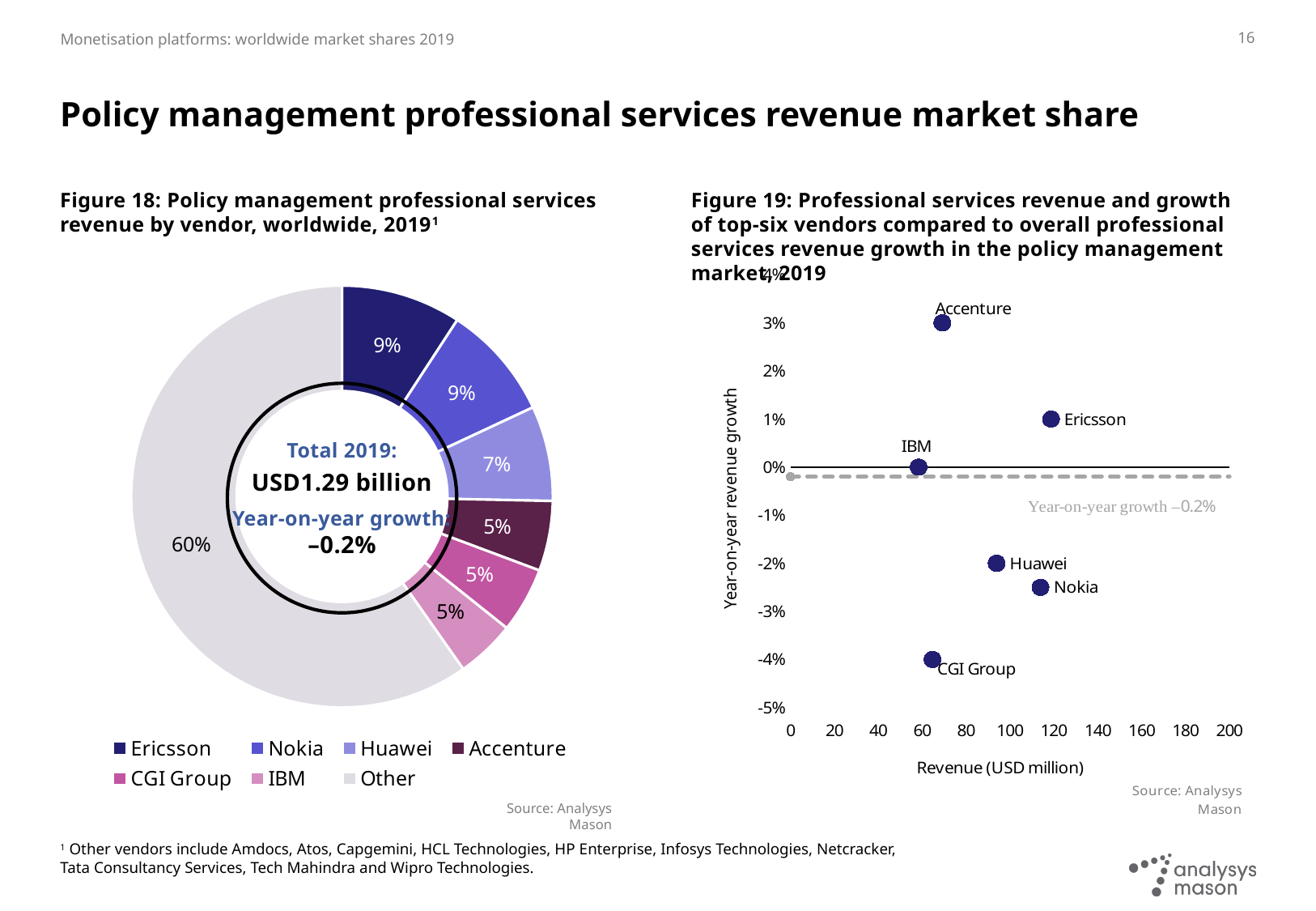
In Figure 19, how many vendors are plotted? 6 In Figure 19, which vendor has the highest year-on-year revenue growth? Accenture In Figure 19, what overall year-on-year growth rate does the dashed line represent? –0.2% In Figure 18, what is Ericsson's share of revenue? 9% In Figure 18, what share of policy management professional services revenue is attributed to Other vendors? 60% In Figure 19, is Ericsson's revenue greater or less than 100 USD million? greater In Figure 18, what is the difference in percentage points between the Other share and Huawei's share? 53 percentage points In Figure 18, what is the total policy management professional services revenue for 2019 shown in the centre of the chart? USD1.29 billion In Figure 18, how many vendor categories does the legend list? 7 What kind of chart is Figure 18? Pie (donut) chart In Figure 18, what is Huawei's share of revenue? 7% In Figure 19, which vendor has the lowest year-on-year revenue growth? CGI Group